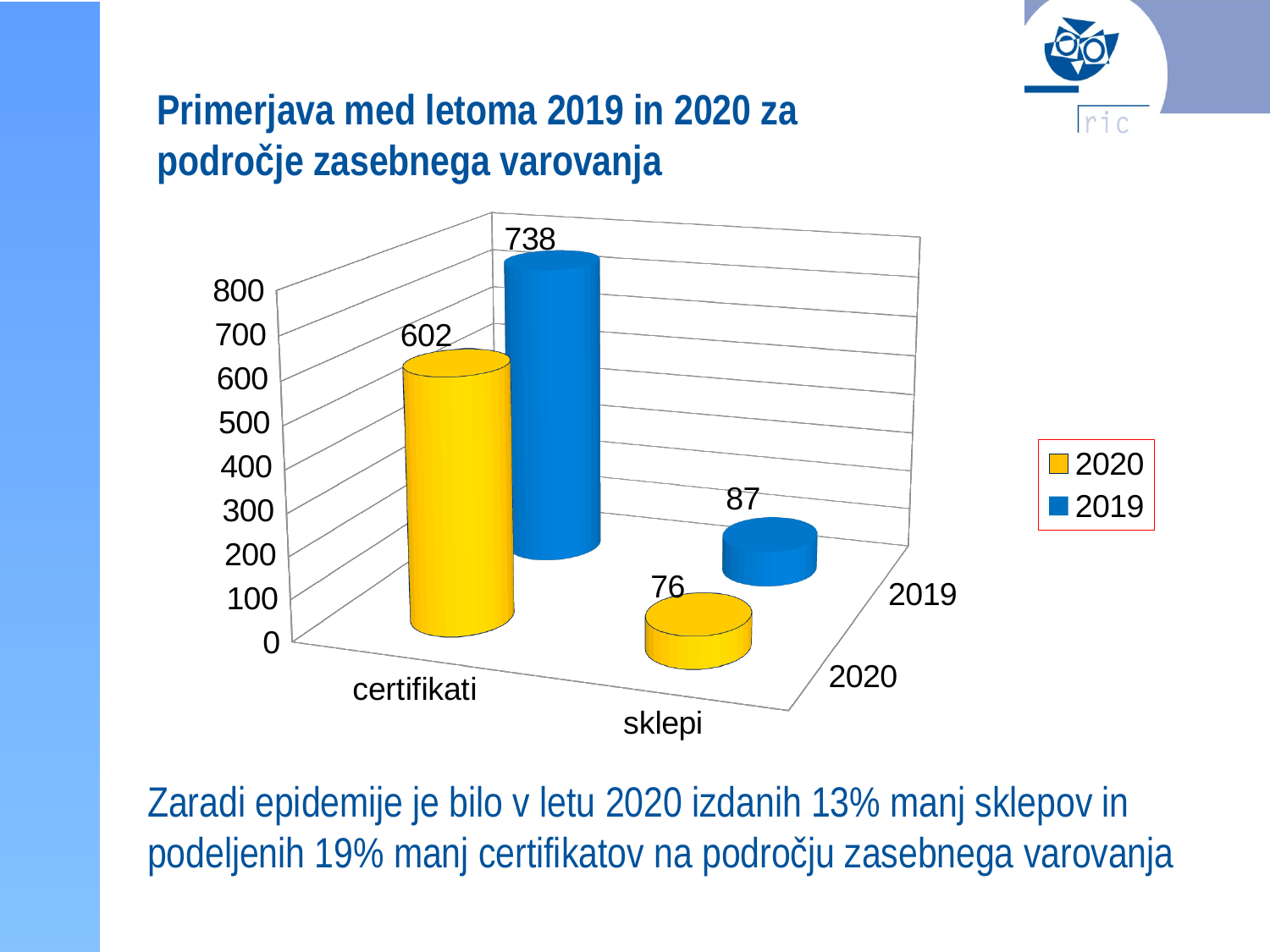
What is the value for sklepi in 2020? 76 Which is larger, the sklepi value for 2019 or for 2020? 2019 What is the difference between the certifikati values for 2019 and 2020? 136 What is the difference between the sklepi values for 2019 and 2020? 11 What kind of chart is shown on the slide? bar chart What is the value for sklepi in 2019? 87 Which category has the highest value in the 2019 series? certifikati What is the value for certifikati in 2019? 738 How many series does the legend list? 2 How many categories are shown on the chart? 2 What is the value for certifikati in 2020? 602 Which category has the lowest value in the 2020 series? sklepi